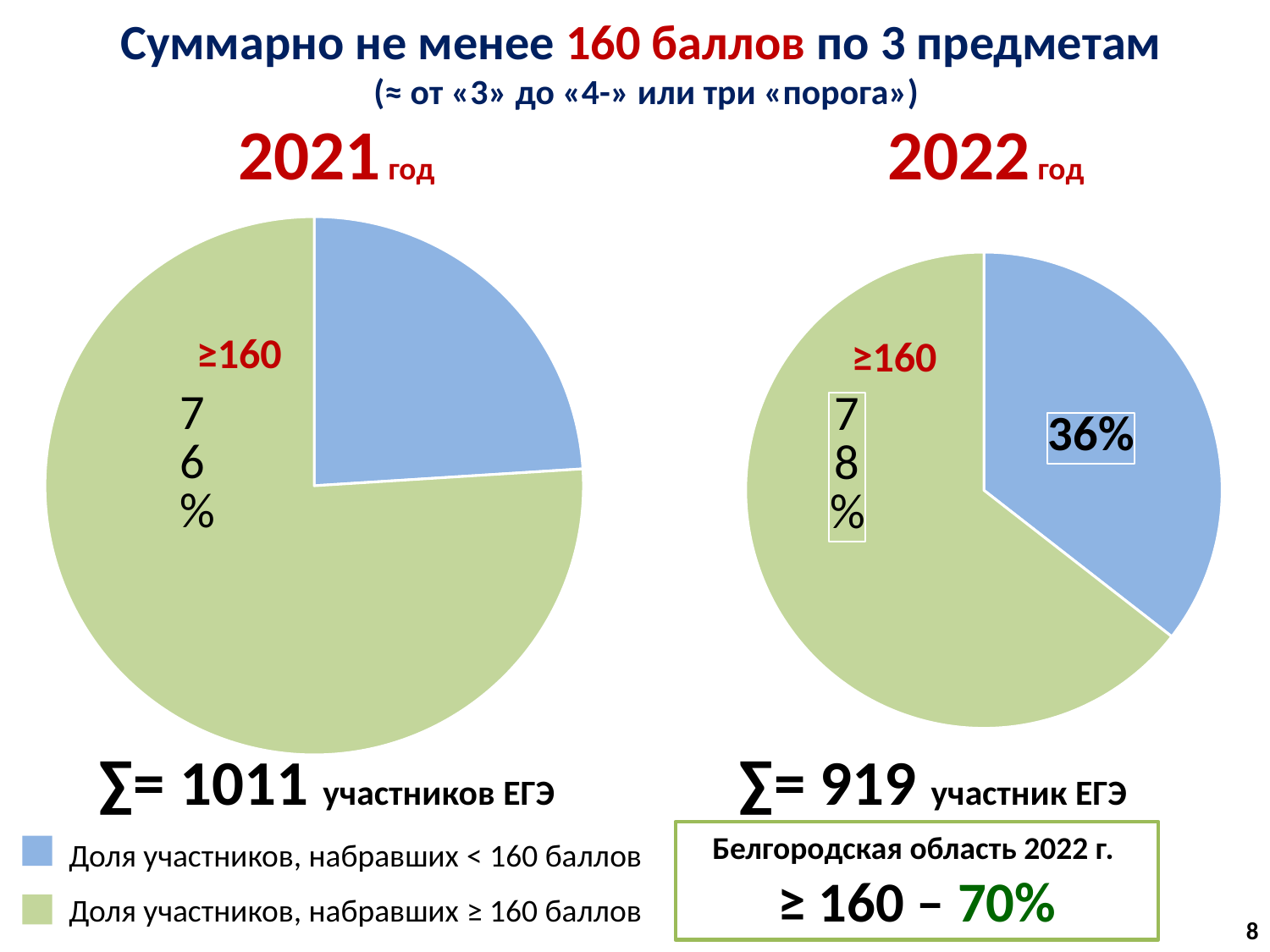
In the 2022 год pie chart, what share is printed for participants who scored ≥160 points? 78% How many ЕГЭ participants are shown in total for the 2021 год chart? 1011 In the 2021 год pie chart, which slice is larger: participants with < 160 points or participants with ≥ 160 points? ≥ 160 points How many ЕГЭ participants are shown in total for the 2022 год chart? 919 How many slices does the 2021 год pie chart have? 2 In the 2022 год pie chart, which slice is larger: participants with < 160 points or participants with ≥ 160 points? ≥ 160 points What type of chart is used for the 2021 год data? pie chart In the 2022 год pie chart, what percentage is printed inside the blue slice? 36% How many entries does the legend list? 2 By how many percentage points does the printed ≥160 share in the 2022 год chart exceed that in the 2021 год chart? 2 Which colour represents the share of participants who scored ≥ 160 points? green In the 2021 год pie chart, what share of participants scored ≥160 points? 76%